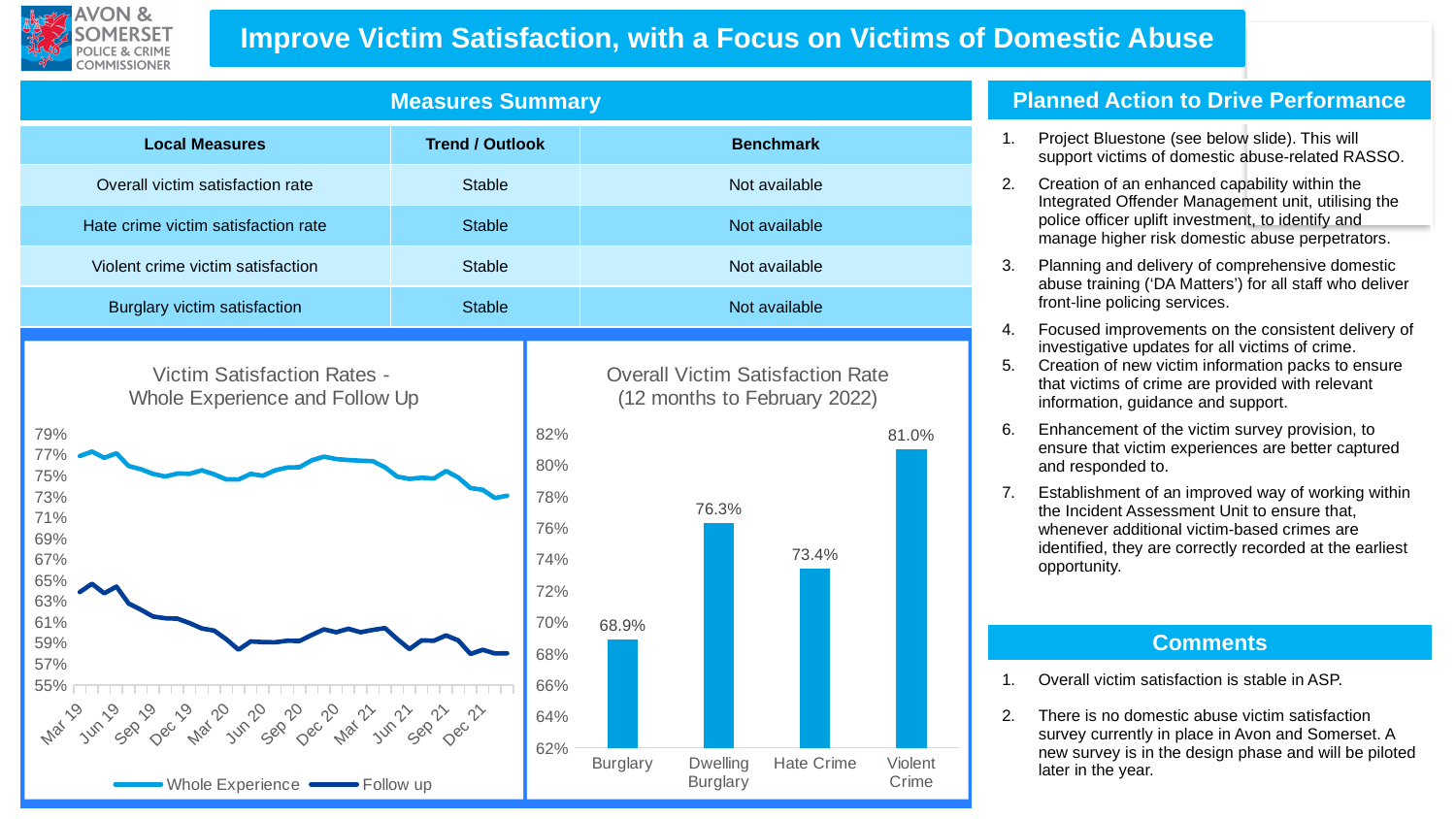
In the 'Overall Victim Satisfaction Rate (12 months to February 2022)' chart, what is the value for Dwelling Burglary? 76.3% In the 'Overall Victim Satisfaction Rate (12 months to February 2022)' chart, which category has the highest satisfaction rate? Violent Crime In the 'Overall Victim Satisfaction Rate (12 months to February 2022)' chart, what is the value for Burglary? 68.9% In the 'Overall Victim Satisfaction Rate (12 months to February 2022)' chart, which category has the lowest satisfaction rate? Burglary In the 'Overall Victim Satisfaction Rate (12 months to February 2022)' chart, what is the difference between the Violent Crime and Burglary values? 12.1% In the 'Victim Satisfaction Rates - Whole Experience and Follow Up' chart, which series has the higher values throughout: Whole Experience or Follow up? Whole Experience How many categories are shown in the 'Overall Victim Satisfaction Rate (12 months to February 2022)' chart? 4 In the 'Victim Satisfaction Rates - Whole Experience and Follow Up' chart, does the Follow up series generally rise or fall from Mar 19 to Dec 21? Fall In the 'Overall Victim Satisfaction Rate (12 months to February 2022)' chart, which is larger: Dwelling Burglary or Hate Crime? Dwelling Burglary What kind of chart is the 'Overall Victim Satisfaction Rate (12 months to February 2022)' chart? Bar chart In the 'Overall Victim Satisfaction Rate (12 months to February 2022)' chart, what is the value for Hate Crime? 73.4% How many series does the legend of the 'Victim Satisfaction Rates - Whole Experience and Follow Up' chart list? 2